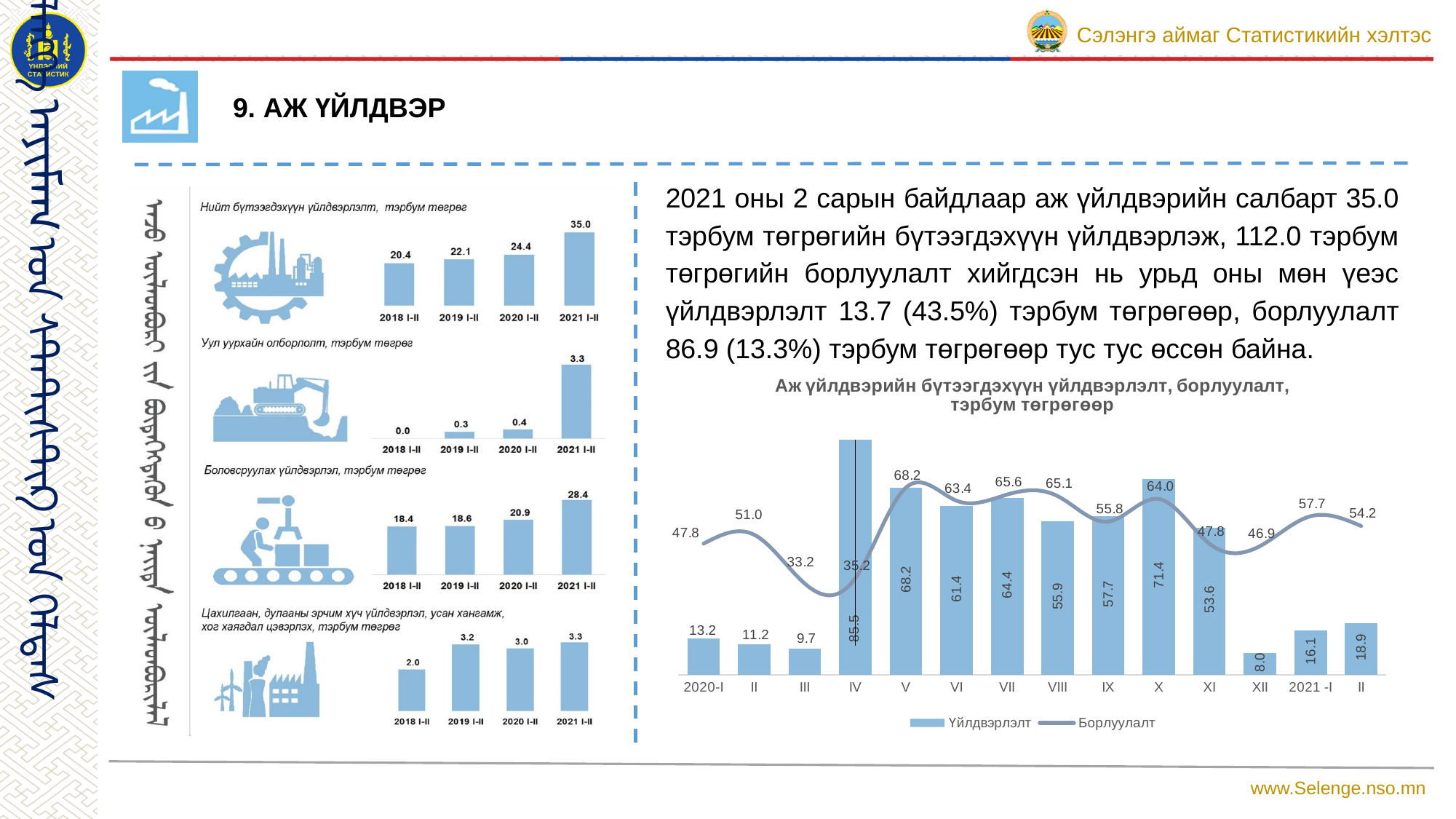
In the chart titled 'Аж үйлдвэрийн бүтээгдэхүүн үйлдвэрлэлт, борлуулалт, тэрбум төгрөгөөр', how many periods are shown on the x axis? 14 In the chart titled 'Аж үйлдвэрийн бүтээгдэхүүн үйлдвэрлэлт, борлуулалт, тэрбум төгрөгөөр', what is the Борлуулалт value for 2021 -I? 57.7 In the chart titled 'Боловсруулах үйлдвэрлэл, тэрбум төгрөг', what is the value for 2019 I-II? 18.6 In the chart titled 'Цахилгаан, дулааны эрчим хүч үйлдвэрлэл, усан хангамж, хог хаягдал цэвэрлэх, тэрбум төгрөг', which period has the lowest value? 2018 I-II In the chart titled 'Нийт бүтээгдэхүүн үйлдвэрлэлт, тэрбум төгрөг', what is the difference between the 2021 I-II and 2020 I-II values? 10.6 In the chart titled 'Уул уурхайн олборлолт, тэрбум төгрөг', which period has the highest value? 2021 I-II In the chart titled 'Аж үйлдвэрийн бүтээгдэхүүн үйлдвэрлэлт, борлуулалт, тэрбум төгрөгөөр', which period has the highest Үйлдвэрлэлт bar? IV In the chart titled 'Аж үйлдвэрийн бүтээгдэхүүн үйлдвэрлэлт, борлуулалт, тэрбум төгрөгөөр', which period has the lowest Үйлдвэрлэлт bar? XII In the chart titled 'Аж үйлдвэрийн бүтээгдэхүүн үйлдвэрлэлт, борлуулалт, тэрбум төгрөгөөр', what is the Үйлдвэрлэлт value for X? 71.4 In the chart titled 'Аж үйлдвэрийн бүтээгдэхүүн үйлдвэрлэлт, борлуулалт, тэрбум төгрөгөөр', how many series does the legend list? 2 In the chart titled 'Цахилгаан, дулааны эрчим хүч үйлдвэрлэл, усан хангамж, хог хаягдал цэвэрлэх, тэрбум төгрөг', which is larger: 2019 I-II or 2020 I-II? 2019 I-II In the chart titled 'Нийт бүтээгдэхүүн үйлдвэрлэлт, тэрбум төгрөг', what is the value for 2021 I-II? 35.0